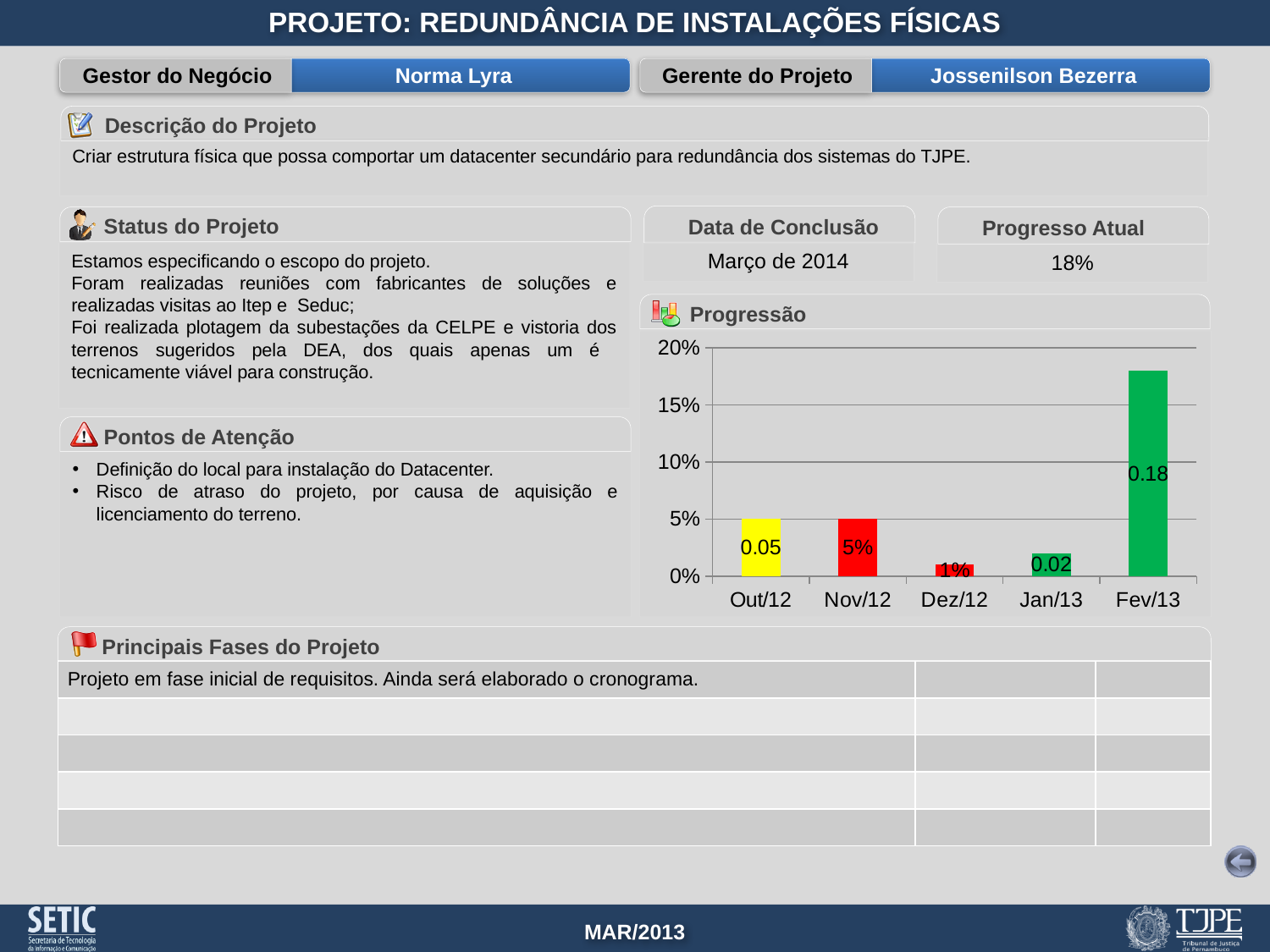
What is the data label shown for Jan/13 in the Progressão chart? 0.02 Is the value for Fev/13 in the Progressão chart greater or less than 15%? greater What is the value shown for Nov/12 in the Progressão chart? 5% In the Progressão chart, what is the difference between the values for Nov/12 and Dez/12? 4% In the Progressão chart, which is larger: the bar for Fev/13 or the bar for Jan/13? Fev/13 What kind of chart is the Progressão chart? bar chart What is the value shown for Dez/12 in the Progressão chart? 1% Which month has the lowest bar in the Progressão chart? Dez/12 How many months are shown on the x axis of the Progressão chart? 5 What is the data label shown for Fev/13 in the Progressão chart? 0.18 What is the data label shown for Out/12 in the Progressão chart? 0.05 Which month has the highest bar in the Progressão chart? Fev/13